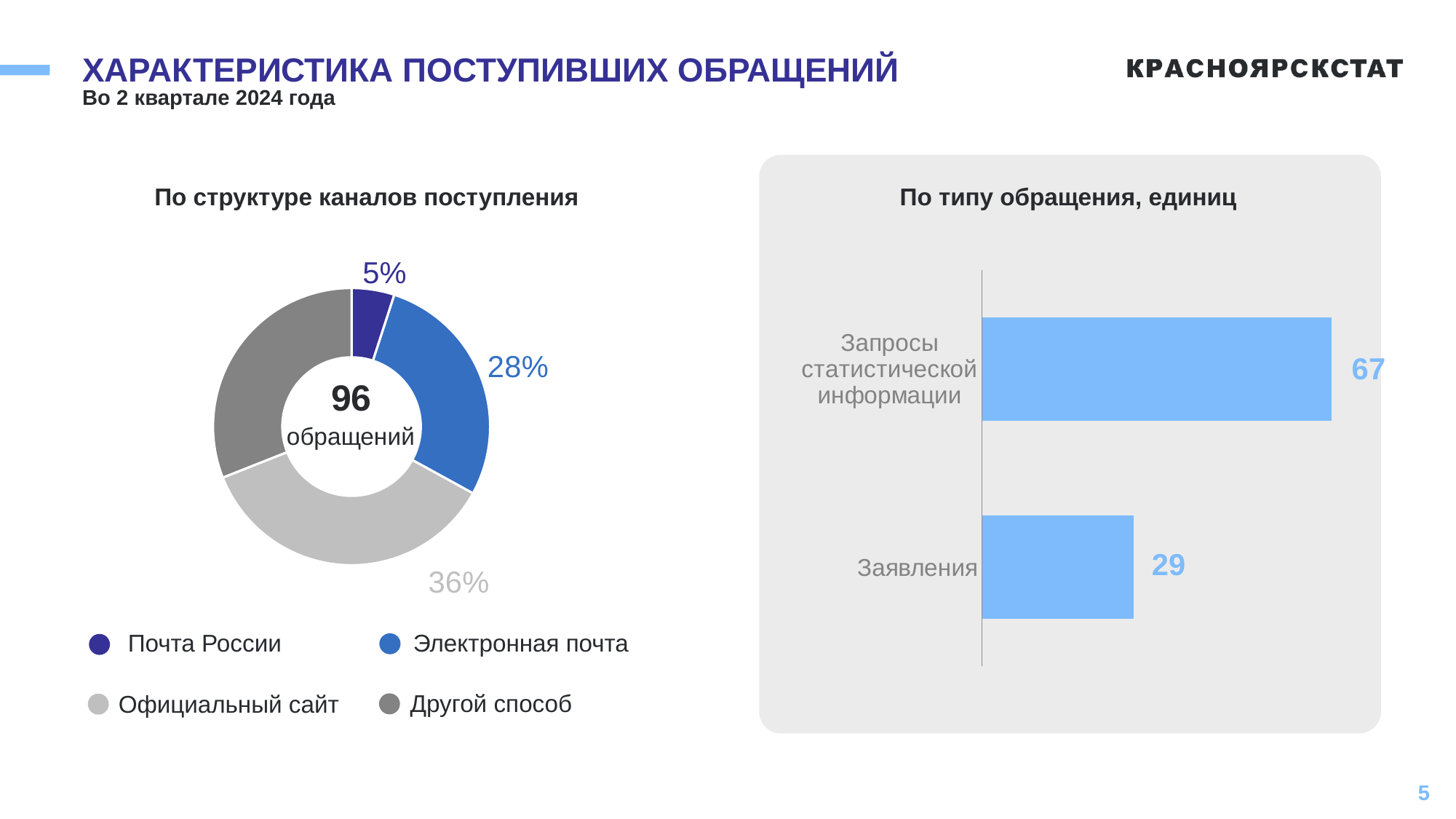
In the chart 'По структуре каналов поступления', how many channels does the legend list? 4 In the chart 'По типу обращения, единиц', what is the difference between Запросы статистической информации and Заявления? 38 In the chart 'По структуре каналов поступления', what total number of обращений is shown in the centre of the donut? 96 In the chart 'По структуре каналов поступления', what share is shown for Почта России? 5% What kind of chart is 'По типу обращения, единиц'? Bar chart In the chart 'По типу обращения, единиц', what is the value for Запросы статистической информации? 67 In the chart 'По типу обращения, единиц', what is the value for Заявления? 29 In the chart 'По структуре каналов поступления', which channel has the smallest share? Почта России In the chart 'По структуре каналов поступления', what share is shown for Электронная почта? 28% In the chart 'По структуре каналов поступления', what share is shown for Официальный сайт? 36% In the chart 'По структуре каналов поступления', which is larger: the share for Электронная почта or the share for Почта России? Электронная почта What kind of chart is 'По структуре каналов поступления'? Donut (pie) chart